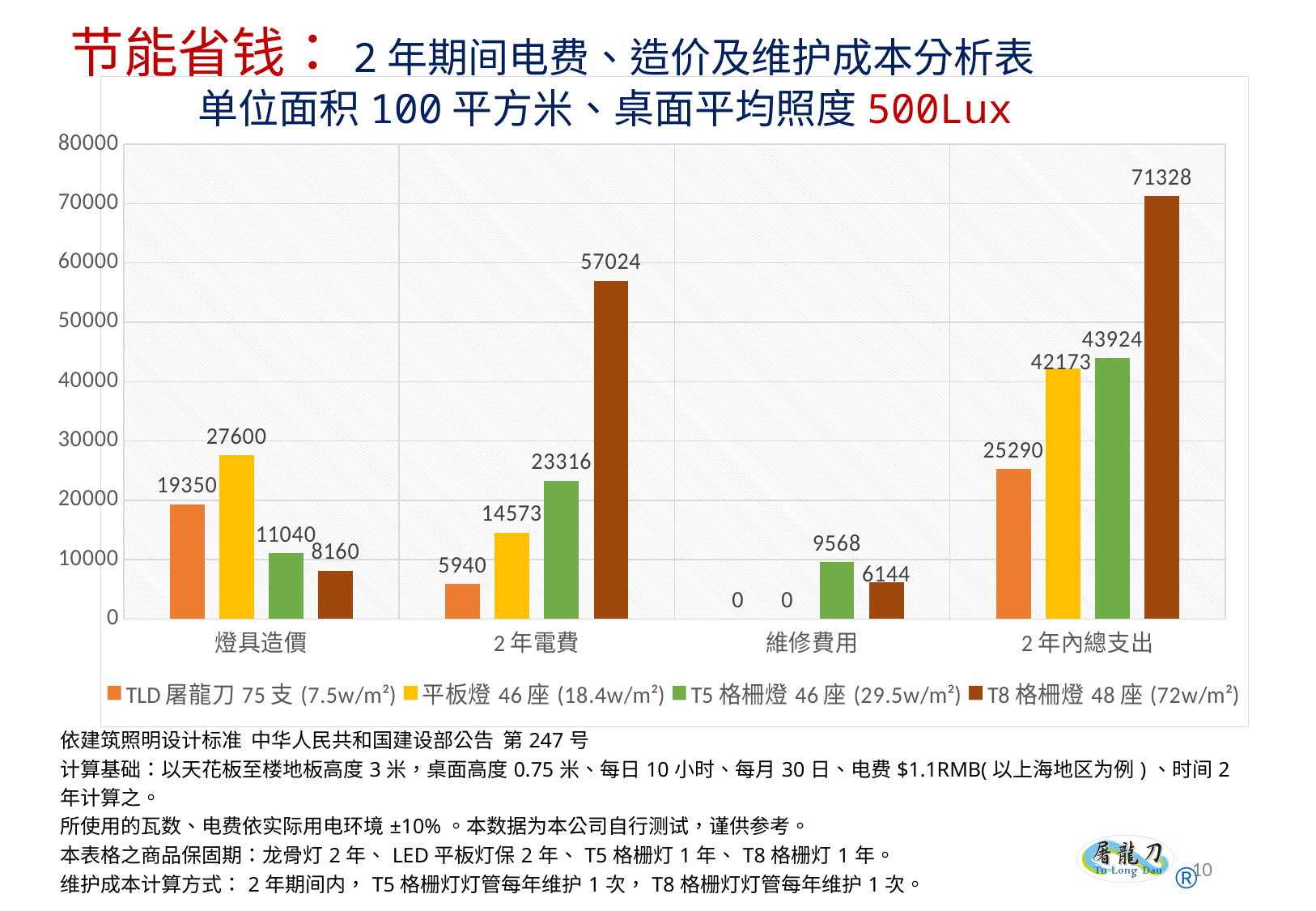
What is the value for TLD 屠龍刀 75支 (7.5w/m²) in the 燈具造價 category? 19350 What is the value for T8 格柵燈 48座 (72w/m²) in the 2年電費 category? 57024 What is the difference between the 2年內總支出 values for T8 格柵燈 48座 (72w/m²) and TLD 屠龍刀 75支 (7.5w/m²)? 46038 Is the value for 平板燈 46座 (18.4w/m²) in the 2年內總支出 category greater or less than 40000? greater How many series does the legend list? 4 Which series has the highest value in the 2年內總支出 category? T8 格柵燈 48座 (72w/m²) How many categories are shown on the x axis? 4 In the 2年電費 category, which is larger: the value for 平板燈 46座 (18.4w/m²) or the value for T5 格柵燈 46座 (29.5w/m²)? T5 格柵燈 46座 (29.5w/m²) Which series has the lowest value in the 燈具造價 category? T8 格柵燈 48座 (72w/m²) What is the value for 平板燈 46座 (18.4w/m²) in the 維修費用 category? 0 What type of chart is shown on the slide? bar chart What is the value for T5 格柵燈 46座 (29.5w/m²) in the 維修費用 category? 9568